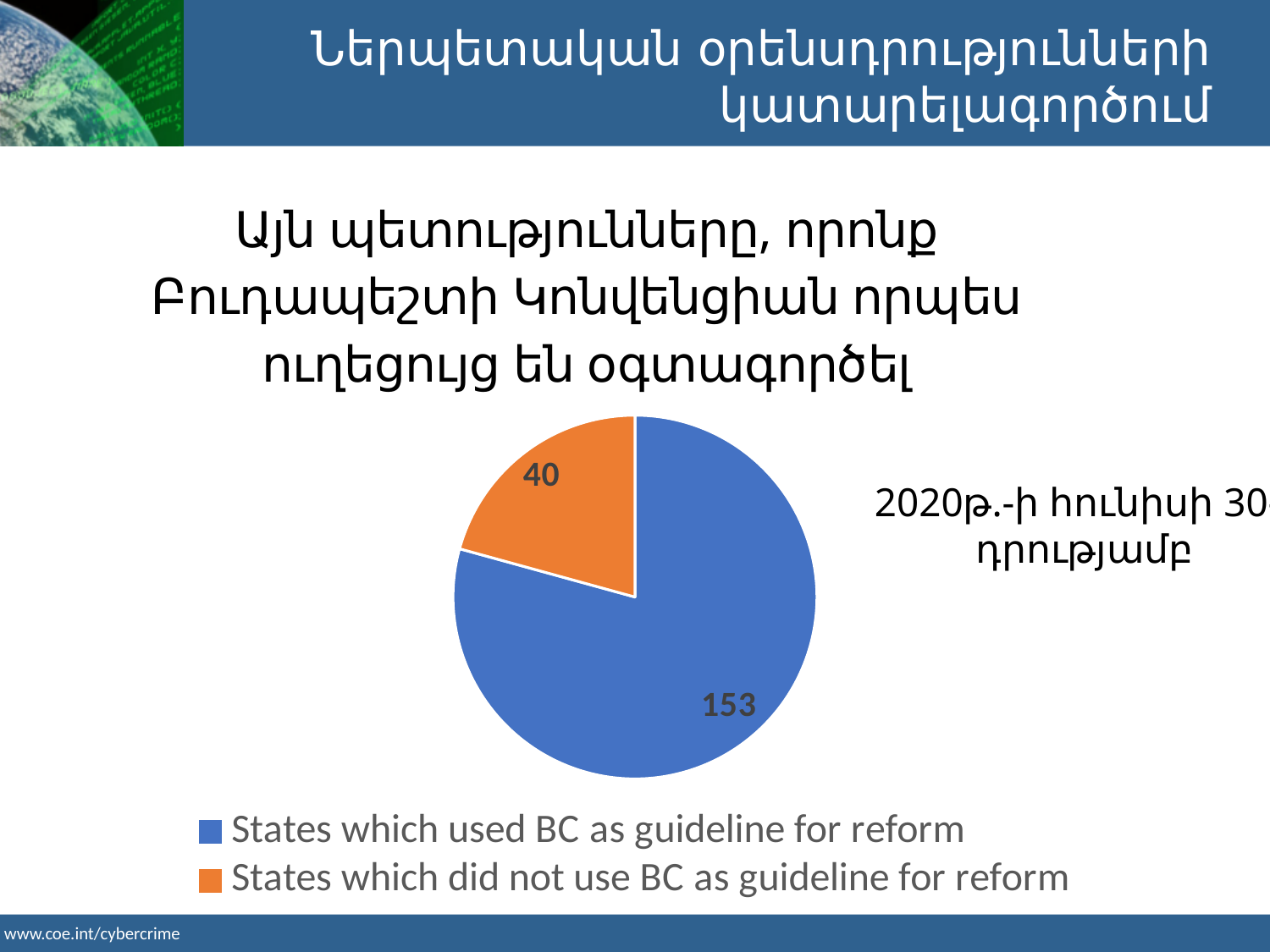
What share of the pie is the slice for 'States which did not use BC as guideline for reform'? 20.7% How many entries does the legend list? 2 What is the value for 'States which did not use BC as guideline for reform'? 40 Which is larger: the number of states which used BC as guideline for reform or the number which did not? States which used BC as guideline for reform What is the value for 'States which used BC as guideline for reform'? 153 How many slices does the pie chart have? 2 What is the total of all slices in the pie chart? 193 What kind of chart is shown on the slide? pie chart Which category has the largest slice of the pie? States which used BC as guideline for reform What colour is the slice for 'States which used BC as guideline for reform'? blue What is the difference between the number of states which used BC as guideline for reform and those which did not? 113 Which category has the smallest slice of the pie? States which did not use BC as guideline for reform